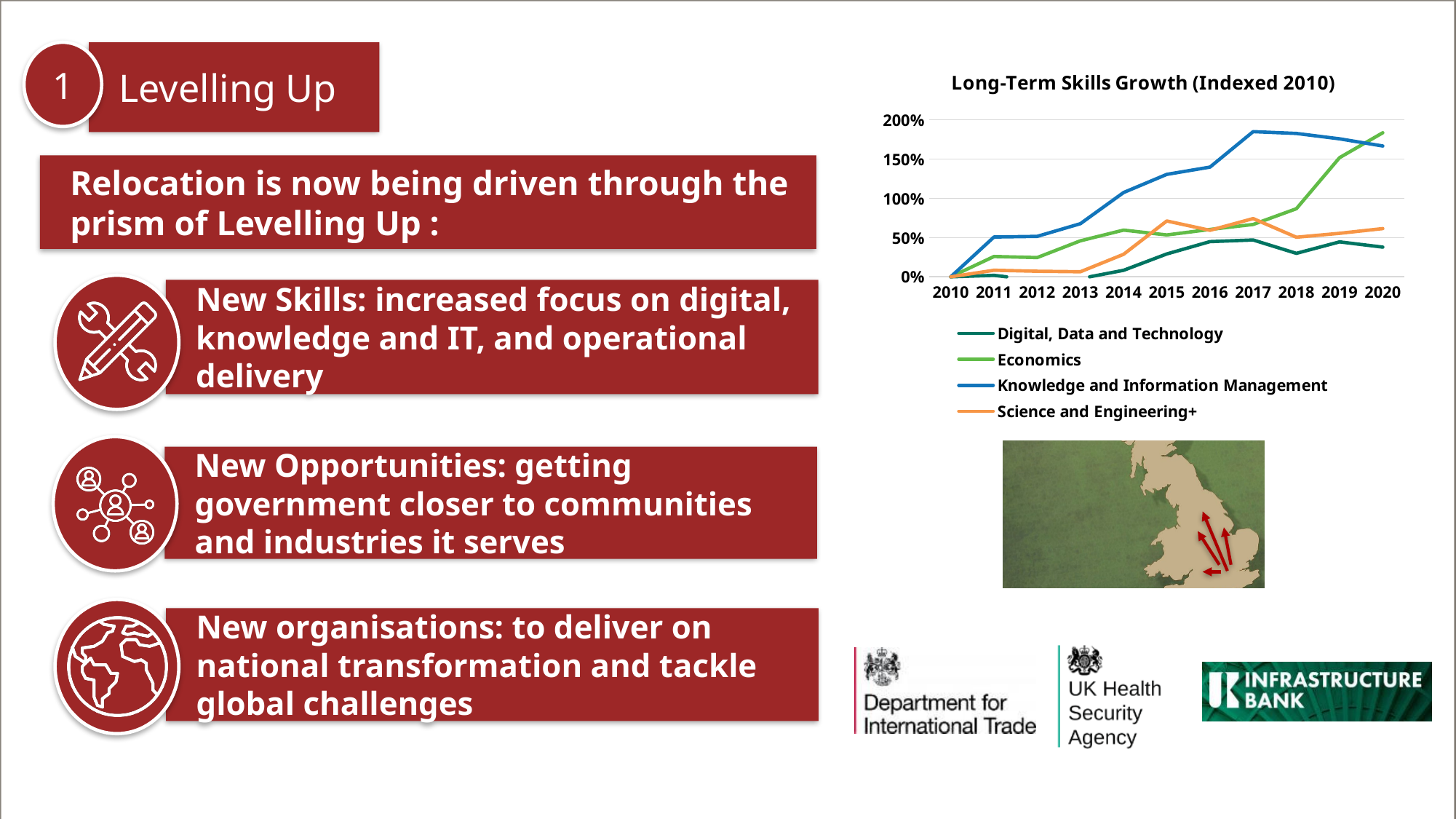
Which series has the highest value in 2017? Knowledge and Information Management Is the value for Knowledge and Information Management in 2017 greater or less than 150%? greater How many years are shown along the x axis of the chart? 11 In 2020, which is larger: the value for Economics or the value for Knowledge and Information Management? Economics Which series has the lowest value in 2020? Digital, Data and Technology How many series does the legend of the chart list? 4 What kind of chart is shown on the slide? line chart Is the value for Science and Engineering+ in 2015 greater or less than 50%? greater Is the value for Digital, Data and Technology in 2020 greater or less than 50%? less What is the title of the chart? Long-Term Skills Growth (Indexed 2010) What is the value for Knowledge and Information Management in 2010? 0%